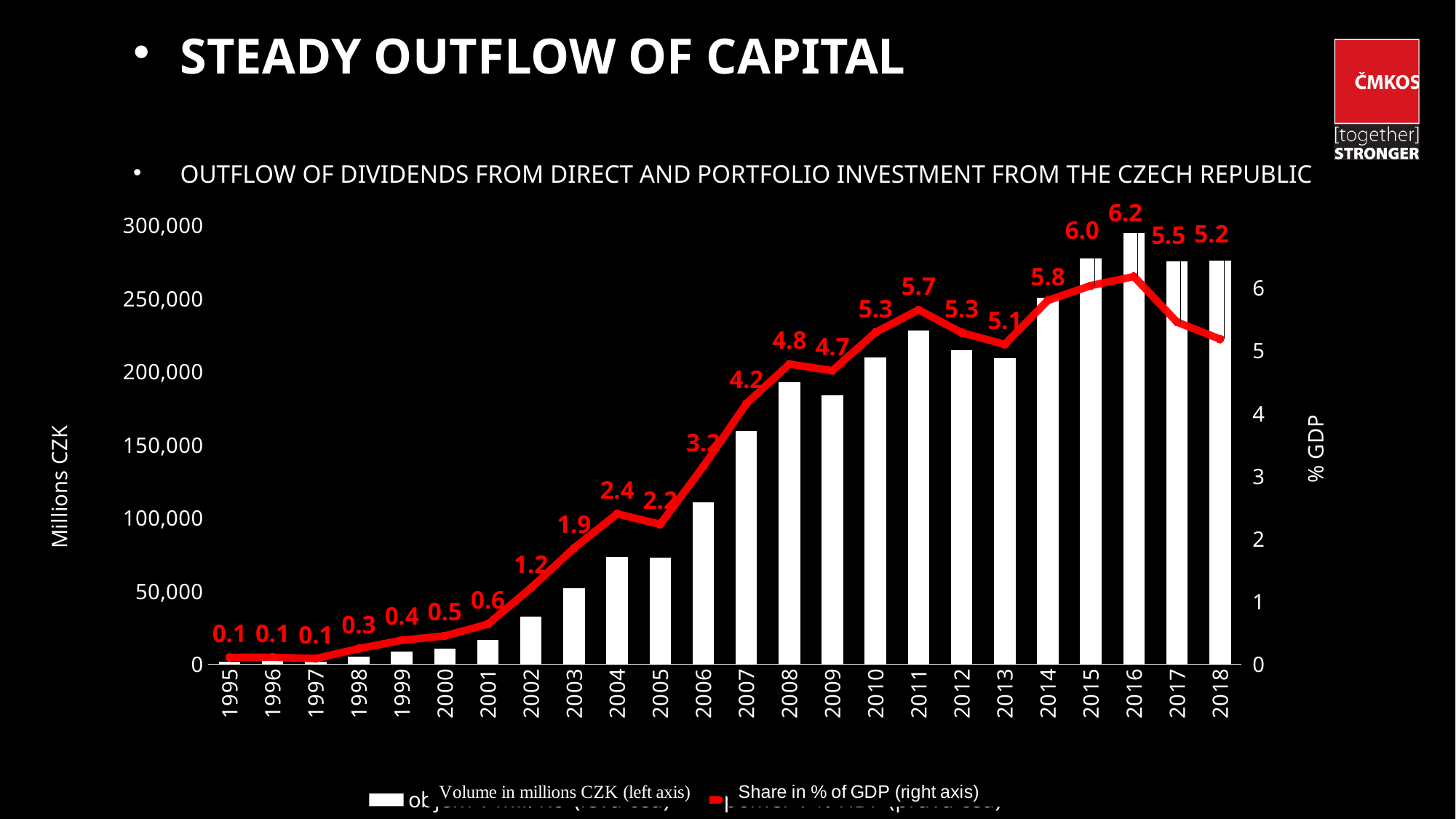
What share of GDP is shown for 2007? 4.2 Which year has the highest share in % of GDP? 2016 How many series does the legend list? 2 Which year has a larger share of GDP, 2011 or 2012? 2011 What share of GDP is shown for 2002? 1.2 What share of GDP is shown for 2016? 6.2 Does the share in % of GDP generally rise or fall from 1995 to 2016? rise What kind of chart is used to show the volume in millions CZK? bar chart What is the difference between the share of GDP in 2016 and in 2018? 1.0 How many years are shown on the x axis? 24 Is the volume in millions CZK for 2002 greater or less than 50,000? less Is the volume in millions CZK for 2016 greater or less than 250,000? greater